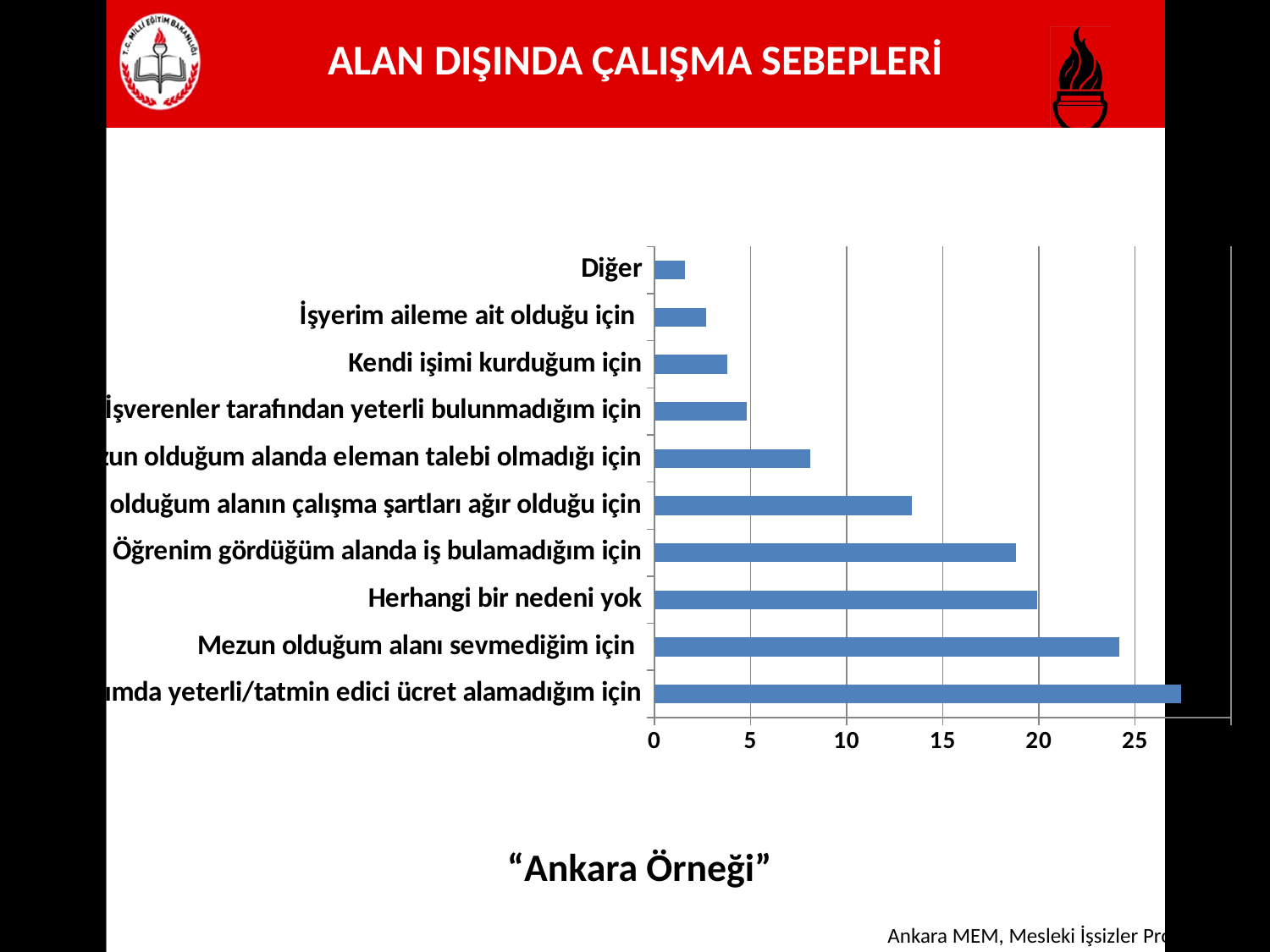
Is the value for "Öğrenim gördüğüm alanda iş bulamadığım için" greater or less than 15? greater What kind of chart is shown on the slide? bar chart Which category has the shortest bar in the chart? Diğer How many categories (bars) does the chart show? 10 Which is larger: the value for "Mezun olduğum alanı sevmediğim için" or for "Herhangi bir nedeni yok"? Mezun olduğum alanı sevmediğim için Is the value for "Mezun olduğum alanı sevmediğim için" greater or less than 20? greater Is the value for "Diğer" greater or less than 5? less What is the title shown at the top of the slide? ALAN DIŞINDA ÇALIŞMA SEBEPLERİ Which is larger: the value for "Diğer" or for "Kendi işimi kurduğum için"? Kendi işimi kurduğum için Going from the top bar to the bottom bar, do the bars get longer or shorter? longer